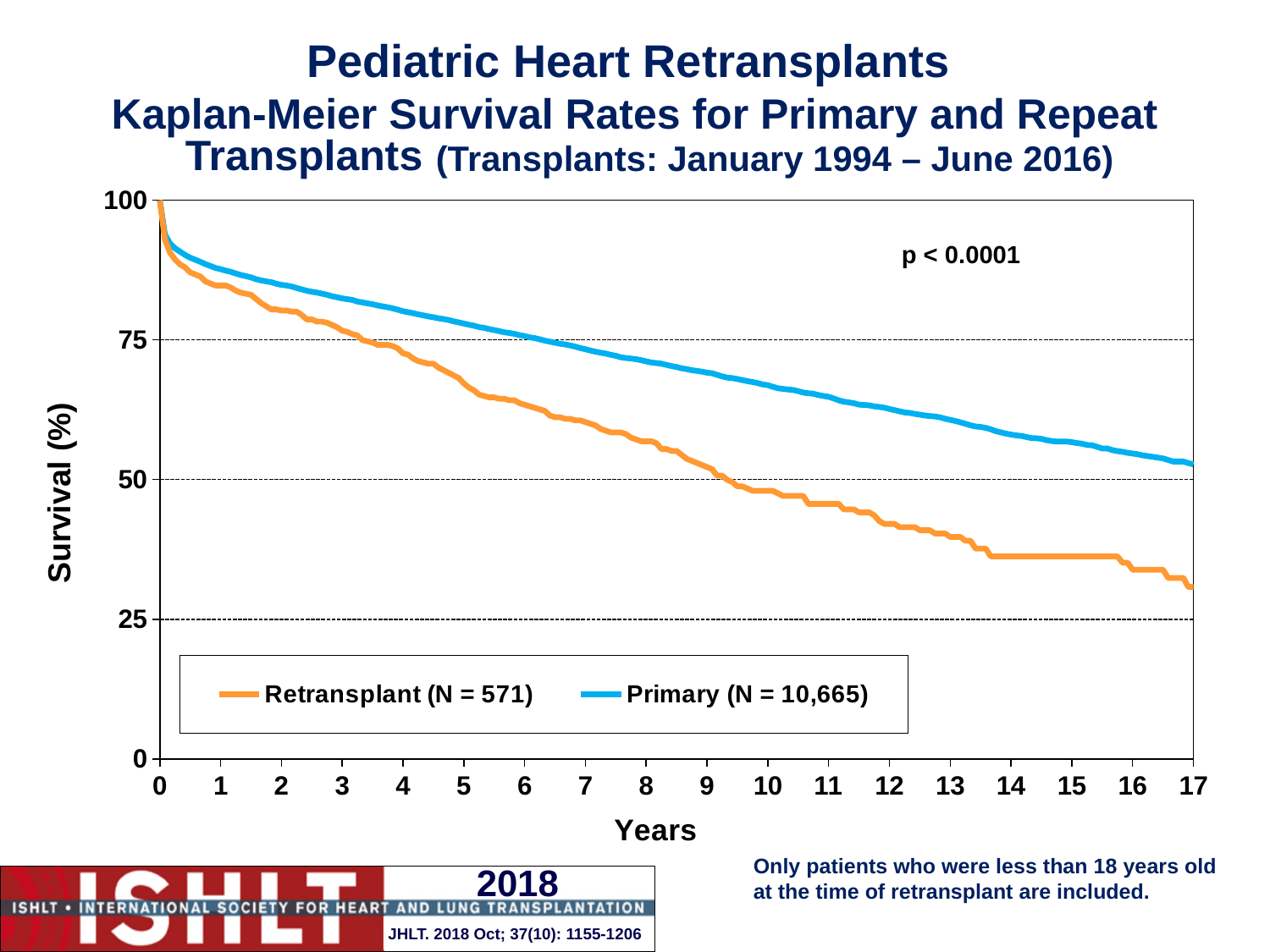
What p-value is shown on the chart? p < 0.0001 Is the survival value for the Retransplant series at 17 years greater or less than 50? less Do the survival values for the Primary series rise or fall along the x axis? fall What is the N shown in the legend for the Retransplant series? 571 What kind of chart is shown on the slide? line chart Is the survival value for the Retransplant series at 5 years greater or less than 50? greater How many series does the legend list? 2 At 10 years, which series has the higher survival, Retransplant or Primary? Primary Do the survival values for the Retransplant series rise or fall as years increase? fall Is the survival value for the Primary series at 5 years greater or less than 75? greater